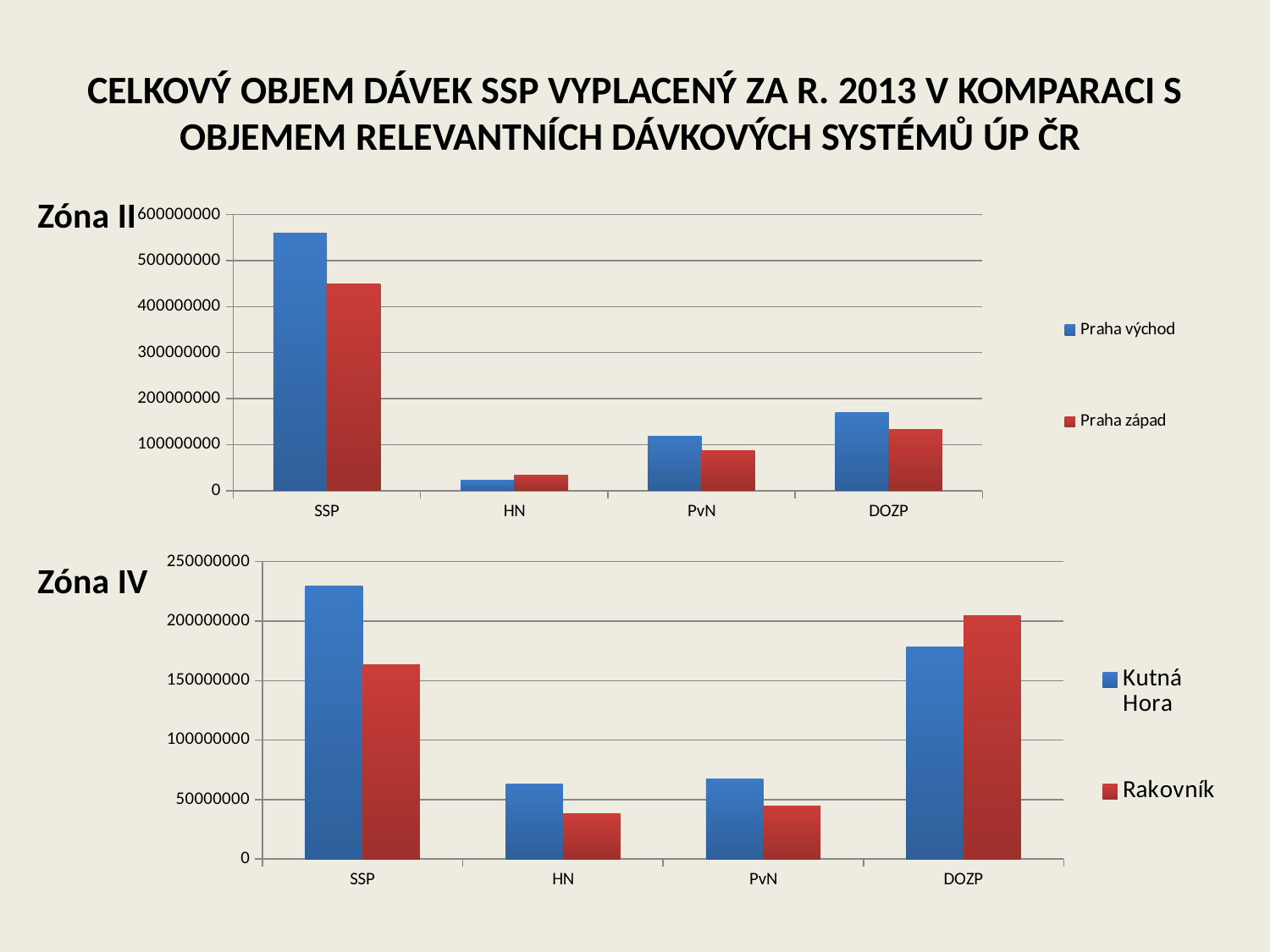
How many series does the legend of the Zóna II chart list? 2 In the Zóna II chart, which category has the highest value for Praha východ? SSP In the Zóna IV chart, is the value for Rakovník at SSP greater or less than 150000000? greater How many categories are shown on the x axis of the Zóna IV chart? 4 What kind of chart is the Zóna II chart? bar chart In the Zóna IV chart, which is larger at DOZP: Kutná Hora or Rakovník? Rakovník In the Zóna II chart, which category has the lowest value for Praha východ? HN In the Zóna IV chart, which category has the lowest value for Rakovník? HN In the Zóna II chart, which is larger at HN: Praha východ or Praha západ? Praha západ What are the two legend entries of the Zóna IV chart? Kutná Hora and Rakovník In the Zóna II chart, is the value for Praha východ at SSP greater or less than 500000000? greater In the Zóna IV chart, which category has the highest value for Kutná Hora? SSP